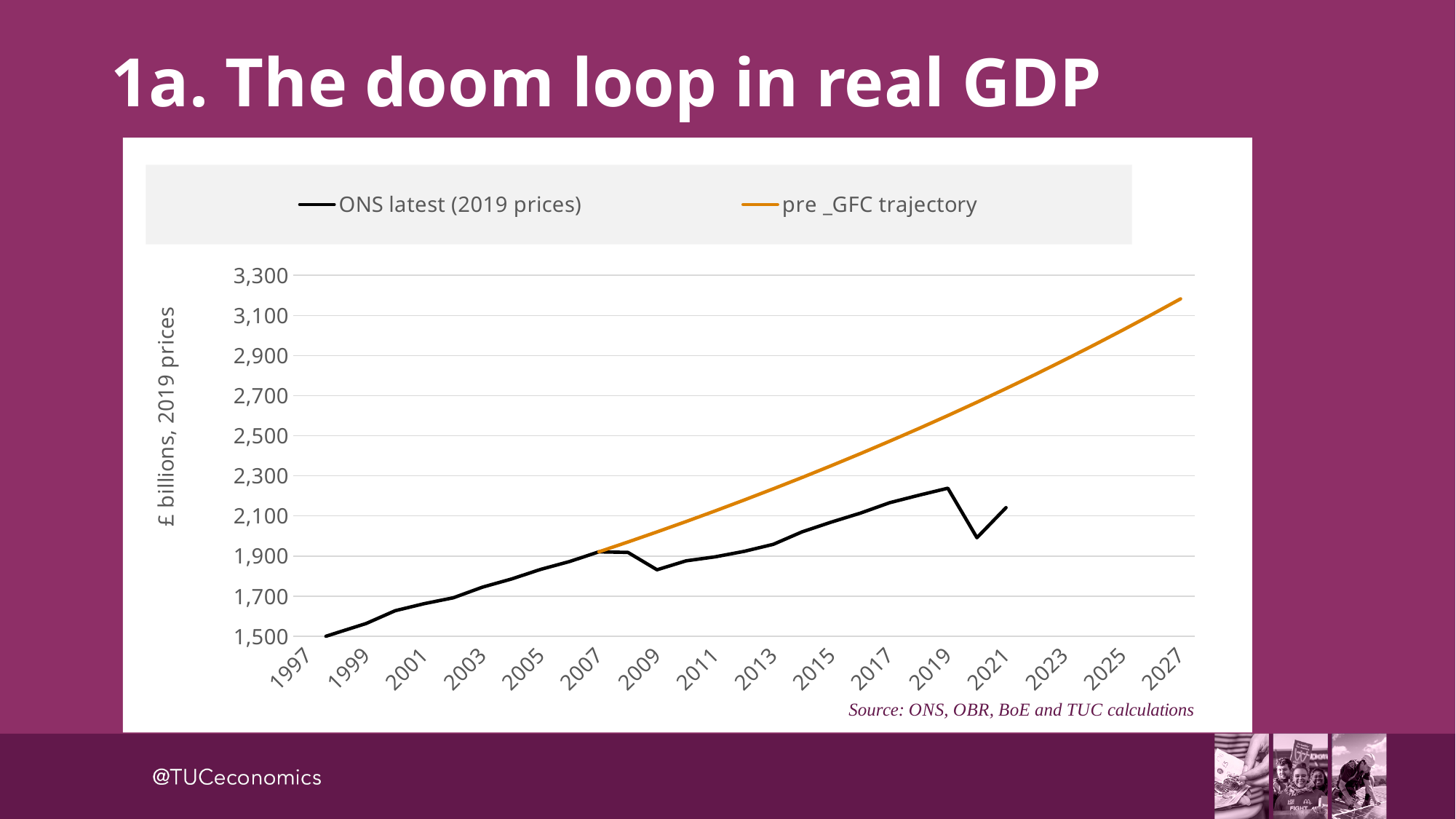
What kind of chart is shown on the slide? line chart Is the value of the pre _GFC trajectory in 2027 greater or less than 2,900? greater Does the pre _GFC trajectory rise or fall from 2007 to 2027? rise Is the value of ONS latest (2019 prices) in 2019 greater or less than 2,100? greater Is the value of ONS latest (2019 prices) in 2020 greater or less than 2,100? less In 2021, which series has the higher value, ONS latest (2019 prices) or pre _GFC trajectory? pre _GFC trajectory Which series is drawn in orange? pre _GFC trajectory How many series does the legend list? 2 Does ONS latest (2019 prices) rise or fall from 2019 to 2020? fall What is the label on the vertical axis? £ billions, 2019 prices